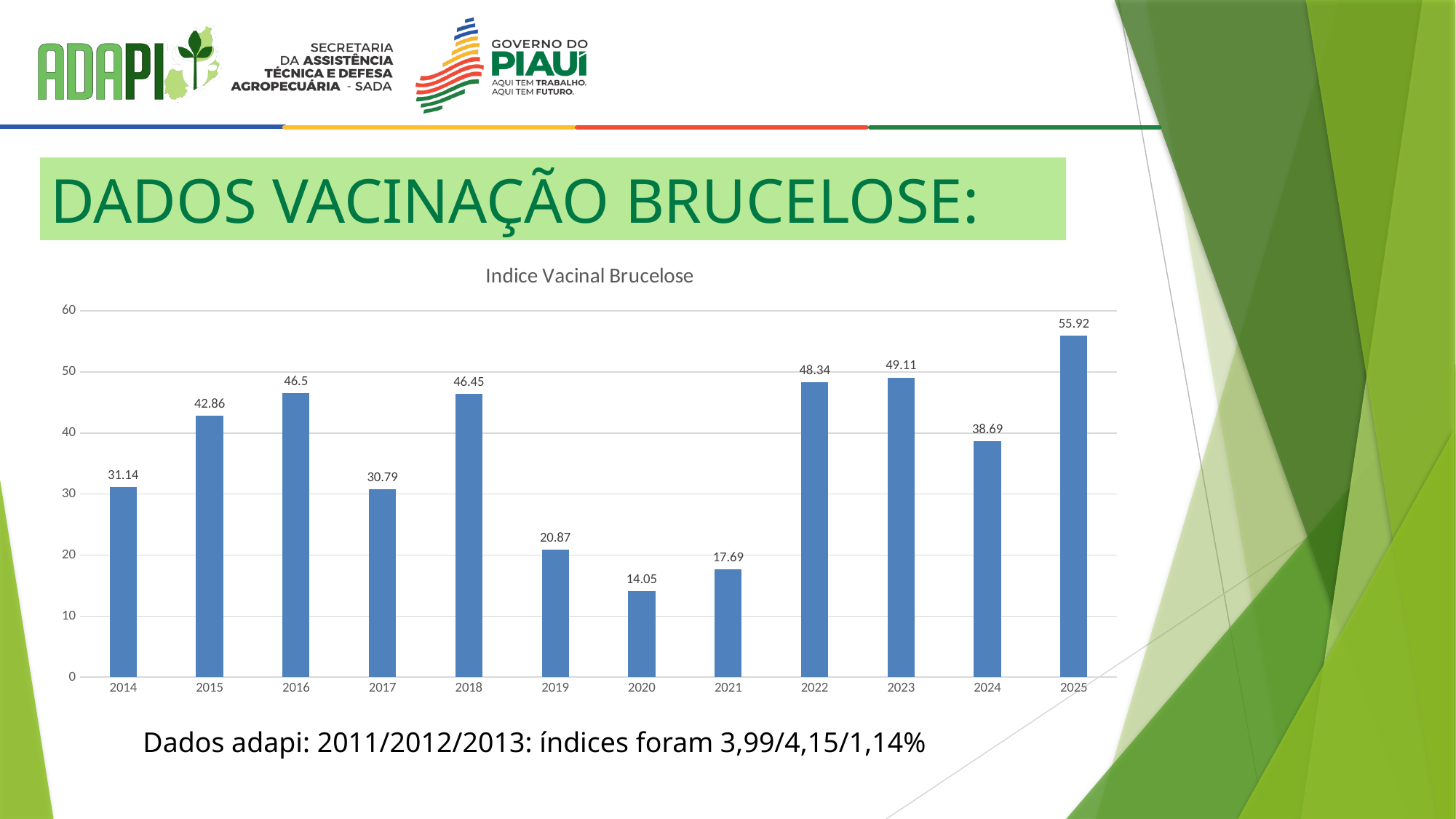
What is the value for 2025 in the Indice Vacinal Brucelose chart? 55.92 Which year has the highest value in the Indice Vacinal Brucelose chart? 2025 Do the values in the Indice Vacinal Brucelose chart rise or fall from 2018 to 2020? Fall What is the value for 2014 in the Indice Vacinal Brucelose chart? 31.14 What is the title of the chart on the slide? Indice Vacinal Brucelose Which year has a larger value in the Indice Vacinal Brucelose chart, 2015 or 2017? 2015 What is the difference between the values for 2025 and 2024 in the Indice Vacinal Brucelose chart? 17.23 Is the value for 2022 in the Indice Vacinal Brucelose chart greater or less than 40? greater What kind of chart is the Indice Vacinal Brucelose chart? Bar chart What is the value for 2020 in the Indice Vacinal Brucelose chart? 14.05 Which year has the lowest value in the Indice Vacinal Brucelose chart? 2020 How many years are shown on the x axis of the Indice Vacinal Brucelose chart? 12